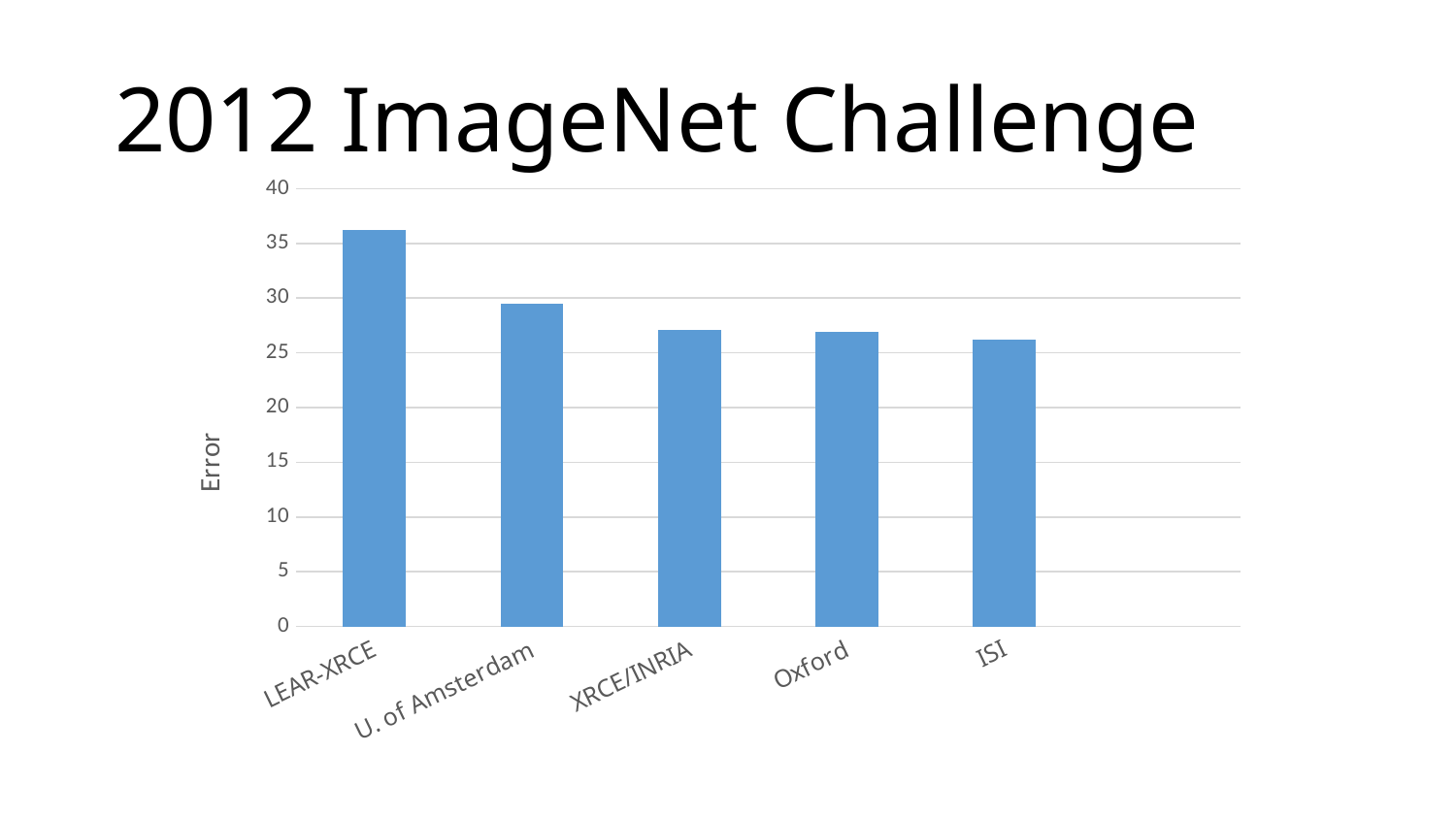
What kind of chart is shown on the slide? bar chart Do the error values generally rise or fall from left to right across the teams? fall Is the error for ISI greater or less than 30? less What is the title of the chart? 2012 ImageNet Challenge Which team has the highest error? LEAR-XRCE Is the error for U. of Amsterdam greater or less than 30? less Is the error for LEAR-XRCE greater or less than 35? greater What is the label on the vertical axis? Error Which has a higher error, LEAR-XRCE or U. of Amsterdam? LEAR-XRCE How many teams (categories) are shown on the x axis? 5